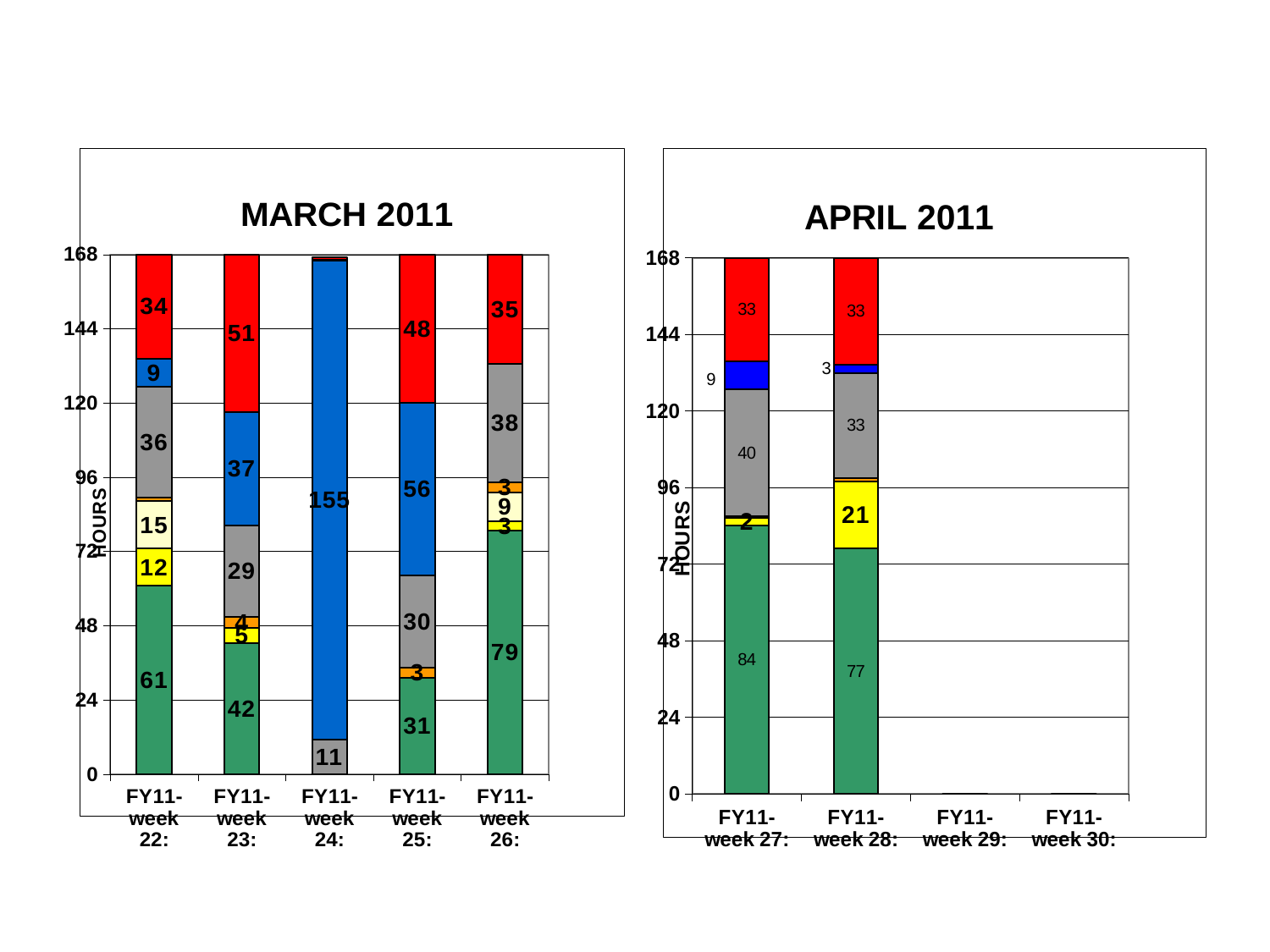
In the APRIL 2011 chart, is the gray segment larger for FY11-week 27 or FY11-week 28? FY11-week 27 In the APRIL 2011 chart, what is the value of the green segment for FY11-week 27? 84 In the MARCH 2011 chart, what is the difference between the green segments of FY11-week 26 and FY11-week 23? 37 In the MARCH 2011 chart, what is the value of the green segment for FY11-week 22? 61 What kind of chart is the MARCH 2011 chart? stacked bar chart In the MARCH 2011 chart, which week has the largest blue segment? FY11-week 24 In the MARCH 2011 chart, what is the total of the stacked bar for FY11-week 25? 168 In the MARCH 2011 chart, what is the value of the red segment for FY11-week 23? 51 What is the y-axis label on the APRIL 2011 chart? HOURS In the MARCH 2011 chart, what is the value of the blue segment for FY11-week 24? 155 In the APRIL 2011 chart, what is the value of the yellow segment for FY11-week 28? 21 How many weeks are shown on the x axis of the MARCH 2011 chart? 5